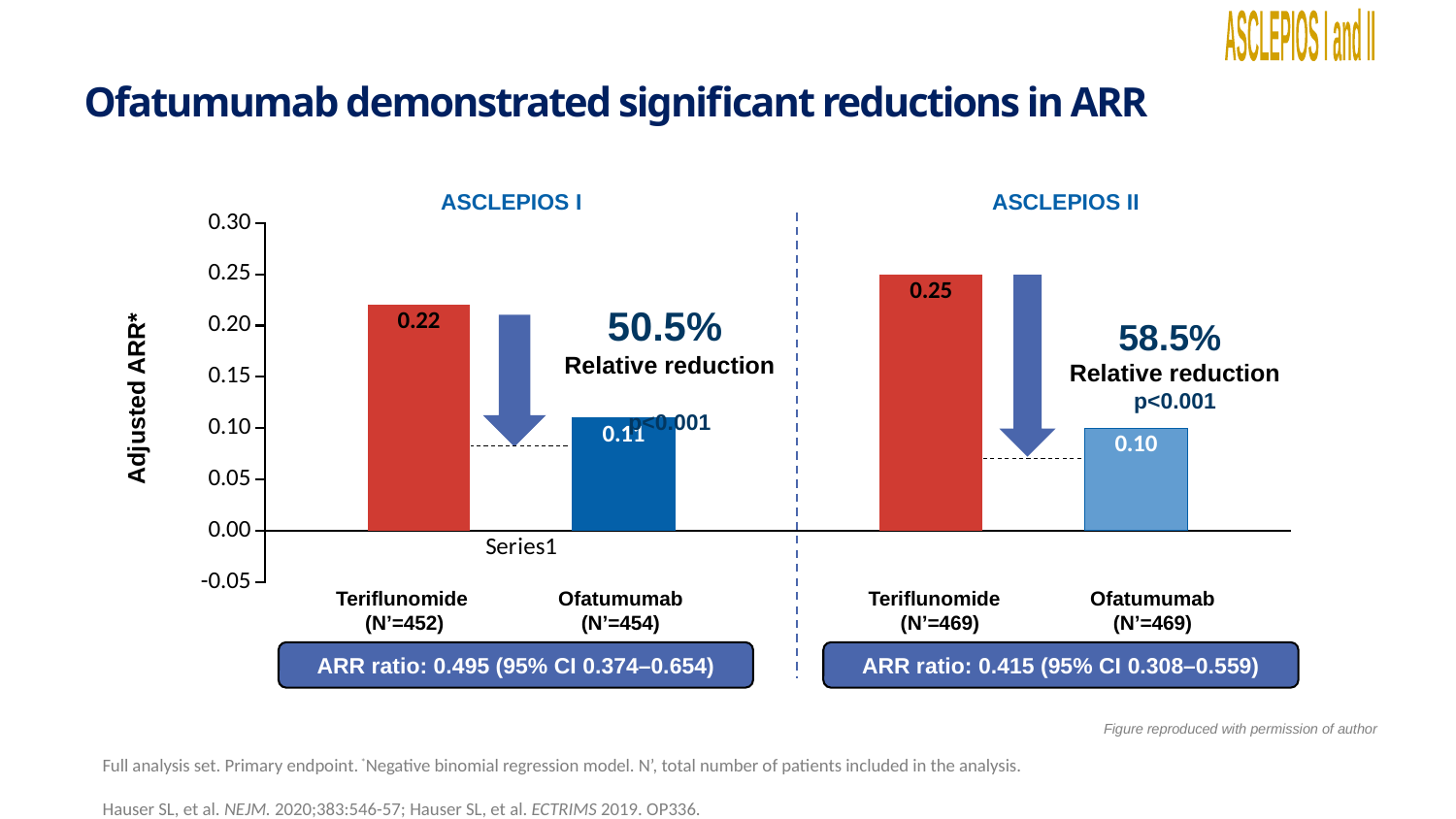
What is the adjusted ARR for ofatumumab in ASCLEPIOS II? 0.10 Which bar has the highest adjusted ARR on the chart? Teriflunomide (ASCLEPIOS II) What is the label on the vertical axis of the chart? Adjusted ARR* Which has a higher adjusted ARR: teriflunomide in ASCLEPIOS I or teriflunomide in ASCLEPIOS II? Teriflunomide in ASCLEPIOS II What is the adjusted ARR for ofatumumab in ASCLEPIOS I? 0.11 What kind of chart is shown on the slide? Bar chart What is the adjusted ARR for teriflunomide in ASCLEPIOS I? 0.22 How many bars are plotted on the chart? 4 Which bar has the lowest adjusted ARR on the chart? Ofatumumab (ASCLEPIOS II) Is the adjusted ARR for teriflunomide in ASCLEPIOS I greater or less than 0.20? greater What is the difference in adjusted ARR between teriflunomide and ofatumumab in ASCLEPIOS II? 0.15 What is the difference in adjusted ARR between teriflunomide and ofatumumab in ASCLEPIOS I? 0.11